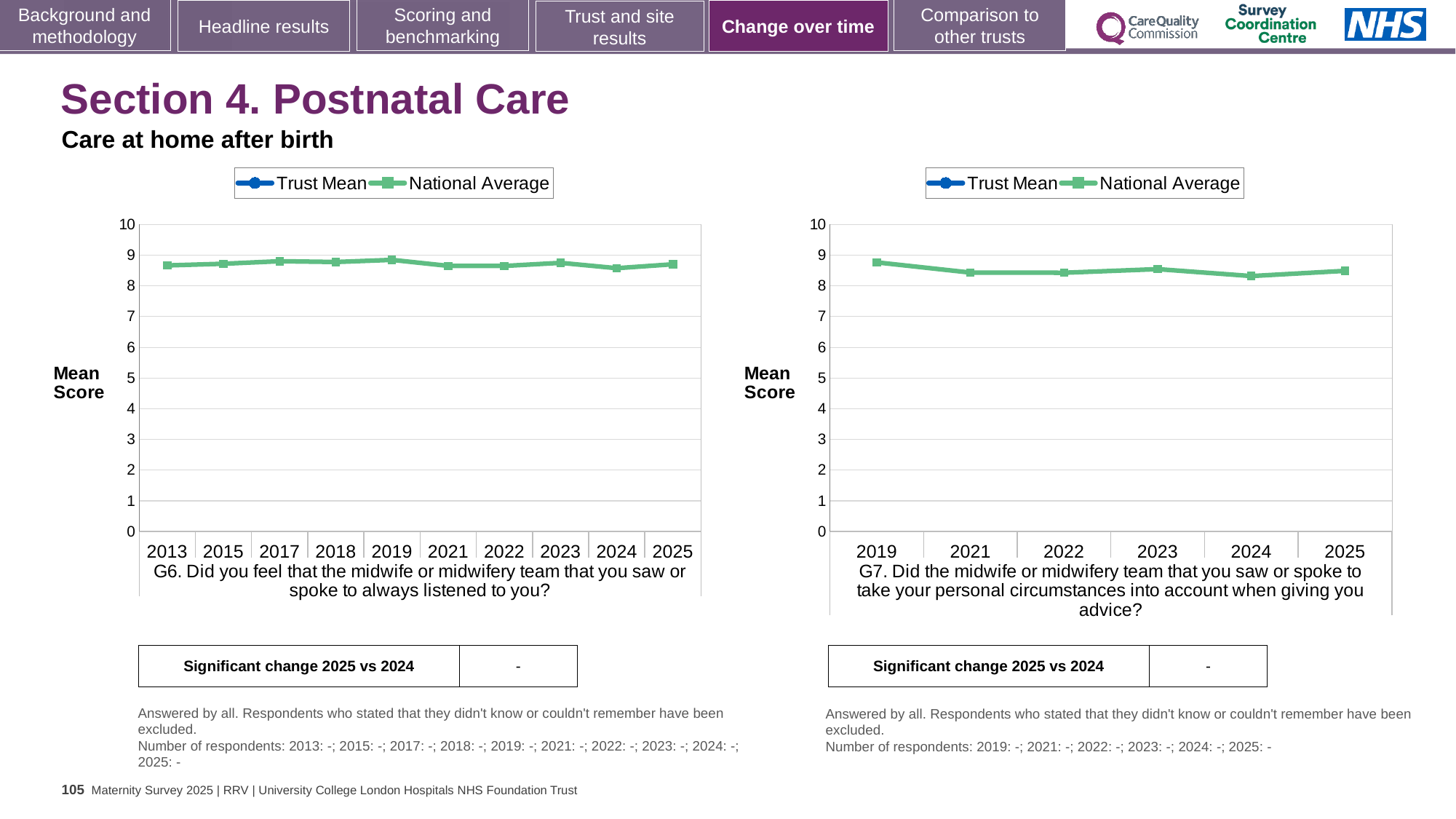
In the G7 chart on the right, which year has the highest National Average value? 2019 How many years are shown on the x axis of the G7 chart on the right? 6 What is the label of the y axis on the G6 chart on the left? Mean Score In the G7 chart on the right, does the National Average rise or fall from 2019 to 2025? fall How many years are shown on the x axis of the G6 chart on the left? 10 In the G6 chart on the left, is the National Average value for 2019 greater or less than 8? greater How many series does the legend of the G7 chart on the right list? 2 What are the two legend entries on the G6 chart on the left? Trust Mean, National Average In the G7 chart on the right, is the National Average value for 2019 larger or smaller than the value for 2024? larger What type of chart is the G6 chart on the left? line chart In the G7 chart on the right, is the National Average value for 2019 greater or less than 8? greater In the G7 chart on the right, is the National Average value for 2024 greater or less than 9? less